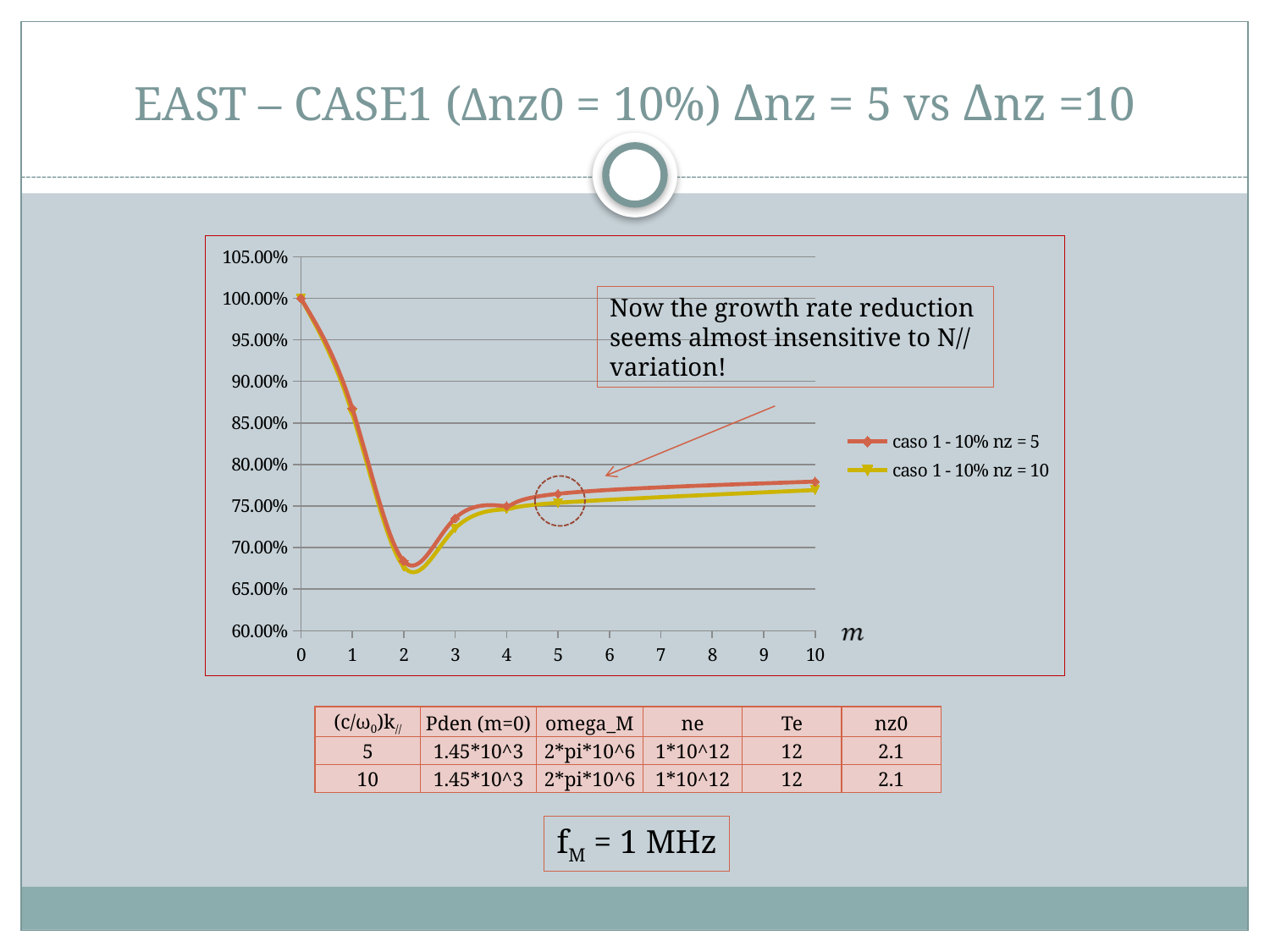
What kind of chart is shown on the slide? line chart How many series does the chart legend list? 2 At m = 10, which series has the higher value: 'caso 1 - 10% nz = 5' or 'caso 1 - 10% nz = 10'? caso 1 - 10% nz = 5 At which value of m do the curves reach their highest point? 0 Do the values rise or fall as m goes from 0 to 2? fall Is the value of the 'caso 1 - 10% nz = 5' series at m = 2 greater or less than 70.00%? less What label is shown on the horizontal axis of the chart? m Is the value of the 'caso 1 - 10% nz = 5' series at m = 1 greater or less than 90.00%? less At which value of m do the curves reach their lowest point? 2 Is the value of the 'caso 1 - 10% nz = 5' series at m = 10 greater or less than 80.00%? less What is the value of both series at m = 0? 100.00% What are the two series named in the chart legend? caso 1 - 10% nz = 5 and caso 1 - 10% nz = 10